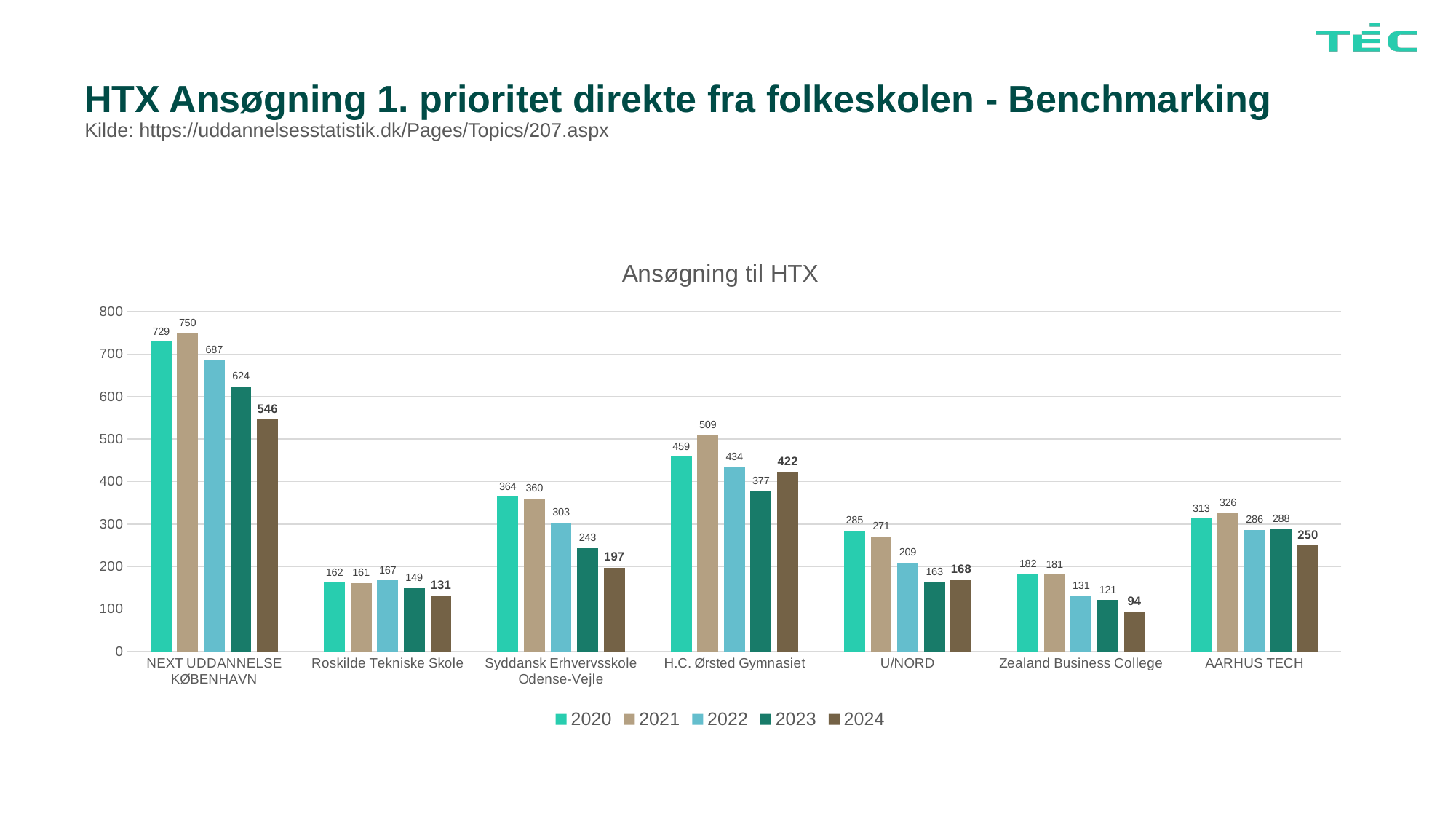
How many schools are shown on the x axis? 7 Which is larger for AARHUS TECH: the 2021 value or the 2024 value? 2021 What is the value for H.C. Ørsted Gymnasiet in 2021? 509 What is the value for NEXT UDDANNELSE KØBENHAVN in 2024? 546 Is the value for U/NORD in 2020 greater or less than 200? greater Which school has the lowest value in 2024? Zealand Business College Which school has the highest value in 2020? NEXT UDDANNELSE KØBENHAVN What is the difference between the 2021 and 2024 values for NEXT UDDANNELSE KØBENHAVN? 204 What kind of chart is shown? Bar chart How many series does the legend list? 5 What is the title of the chart? Ansøgning til HTX What is the value for Zealand Business College in 2024? 94